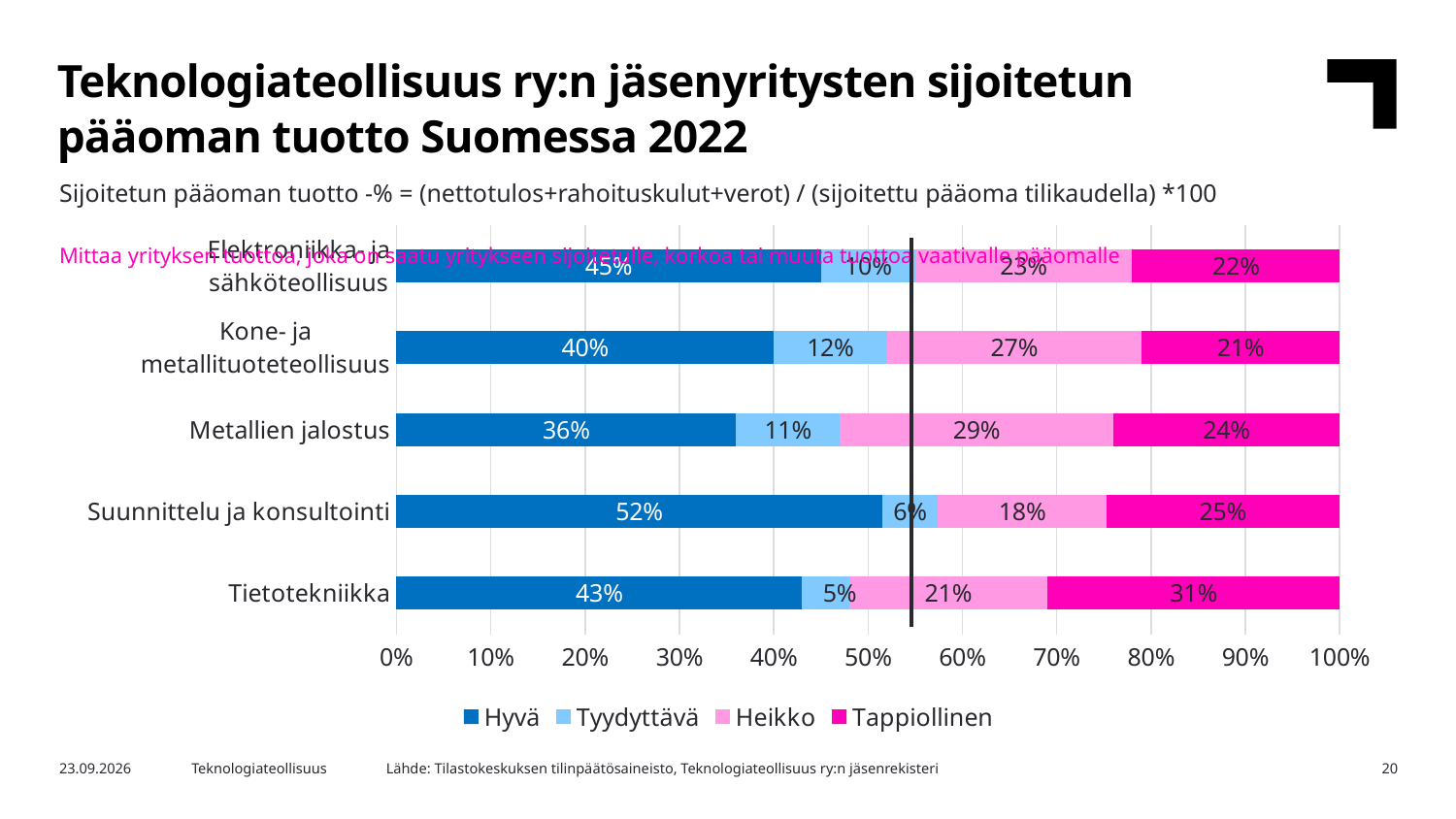
Which legend entry is shown in the darkest blue colour? Hyvä Which category has the highest Hyvä share? Suunnittelu ja konsultointi How many industry categories are plotted on the chart? 5 What is the Hyvä share for Suunnittelu ja konsultointi? 52% What is the Tappiollinen share for Tietotekniikka? 31% Which is larger: the Tappiollinen share for Tietotekniikka or for Kone- ja metallituoteteollisuus? Tietotekniikka What is the difference between the Hyvä shares of Suunnittelu ja konsultointi and Metallien jalostus? 16 percentage points What kind of chart is shown on the slide? Stacked bar chart What is the Tyydyttävä share for Kone- ja metallituoteteollisuus? 12% Which category has the lowest Tyydyttävä share? Tietotekniikka What is the Heikko share for Metallien jalostus? 29% How many series does the legend list? 4